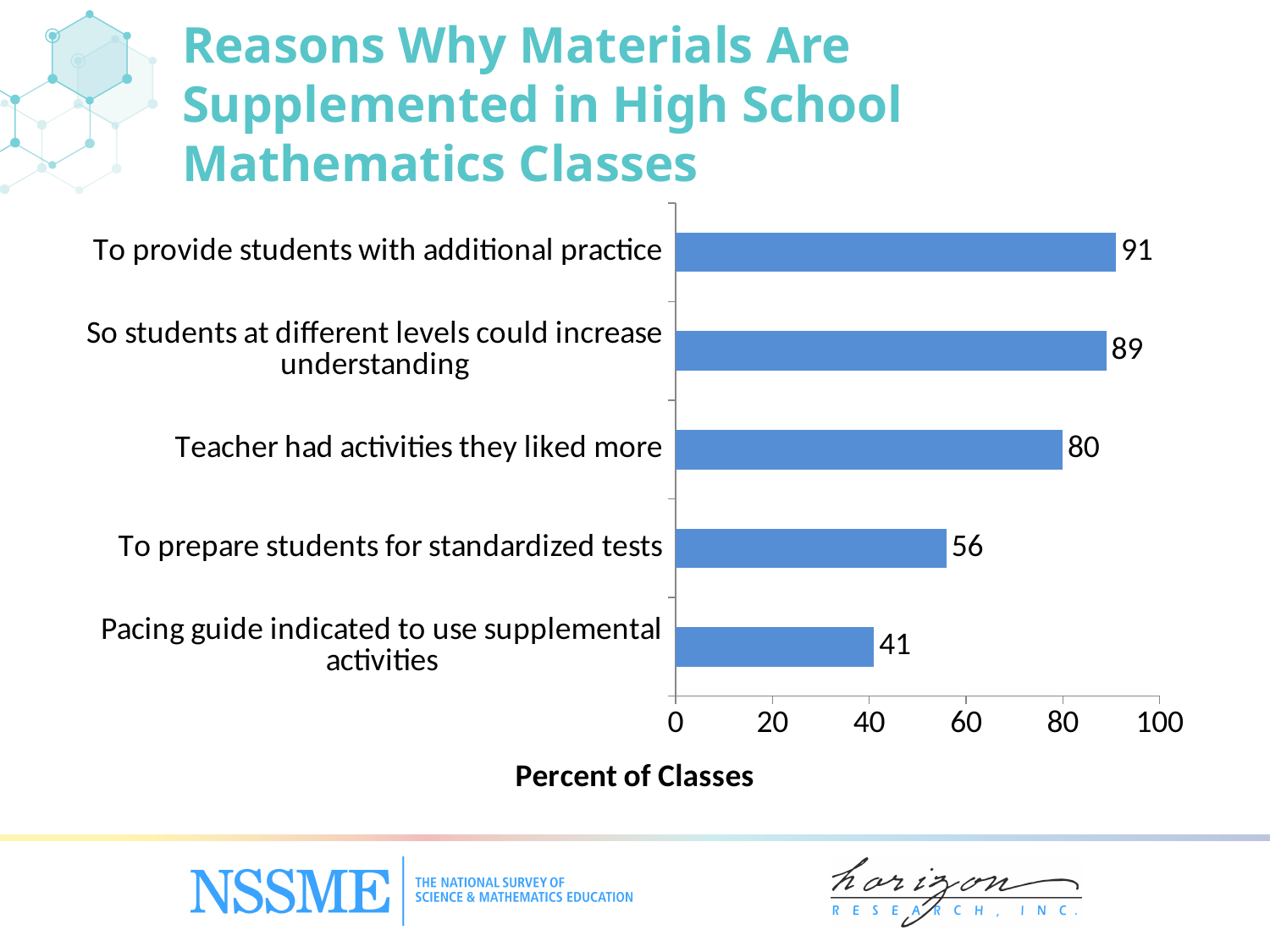
What is the difference between the values for "Teacher had activities they liked more" and "Pacing guide indicated to use supplemental activities"? 39 How many reasons are shown in the chart? 5 What is the value for "Teacher had activities they liked more"? 80 Which reason has the highest percent of classes? To provide students with additional practice What is the difference between the values for "To provide students with additional practice" and "To prepare students for standardized tests"? 35 What is the value for "Pacing guide indicated to use supplemental activities"? 41 What is the value for "To provide students with additional practice"? 91 Is the value for "To prepare students for standardized tests" greater or less than 60? less Which is larger: the value for "Teacher had activities they liked more" or the value for "To prepare students for standardized tests"? Teacher had activities they liked more Which reason has the lowest percent of classes? Pacing guide indicated to use supplemental activities What kind of chart is shown on the slide? bar chart What is the label of the horizontal axis? Percent of Classes